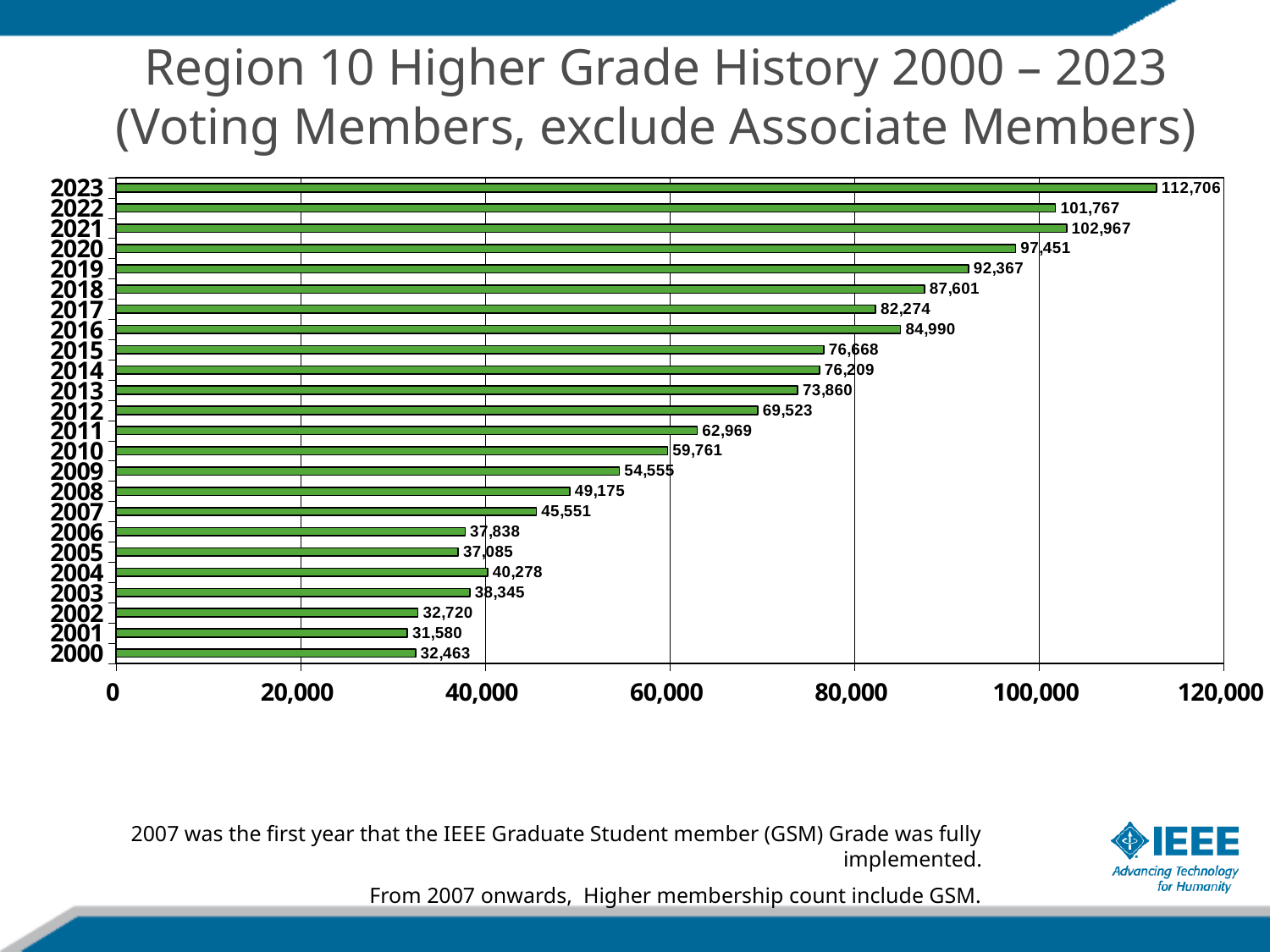
Is the value for 2015 greater or less than 60,000? greater Which year has the highest value? 2023 What is the value for 2007? 45,551 What is the difference between the values for 2023 and 2022? 10,939 What is the value for 2023? 112,706 What kind of chart is shown on the slide? bar chart What is the value for 2000? 32,463 Which year has the lowest value? 2001 Which is larger, the value for 2021 or the value for 2022? 2021 How many years are shown in the chart? 24 Do the values generally rise or fall from 2000 to 2023? rise What is the difference between the values for 2023 and 2000? 80,243